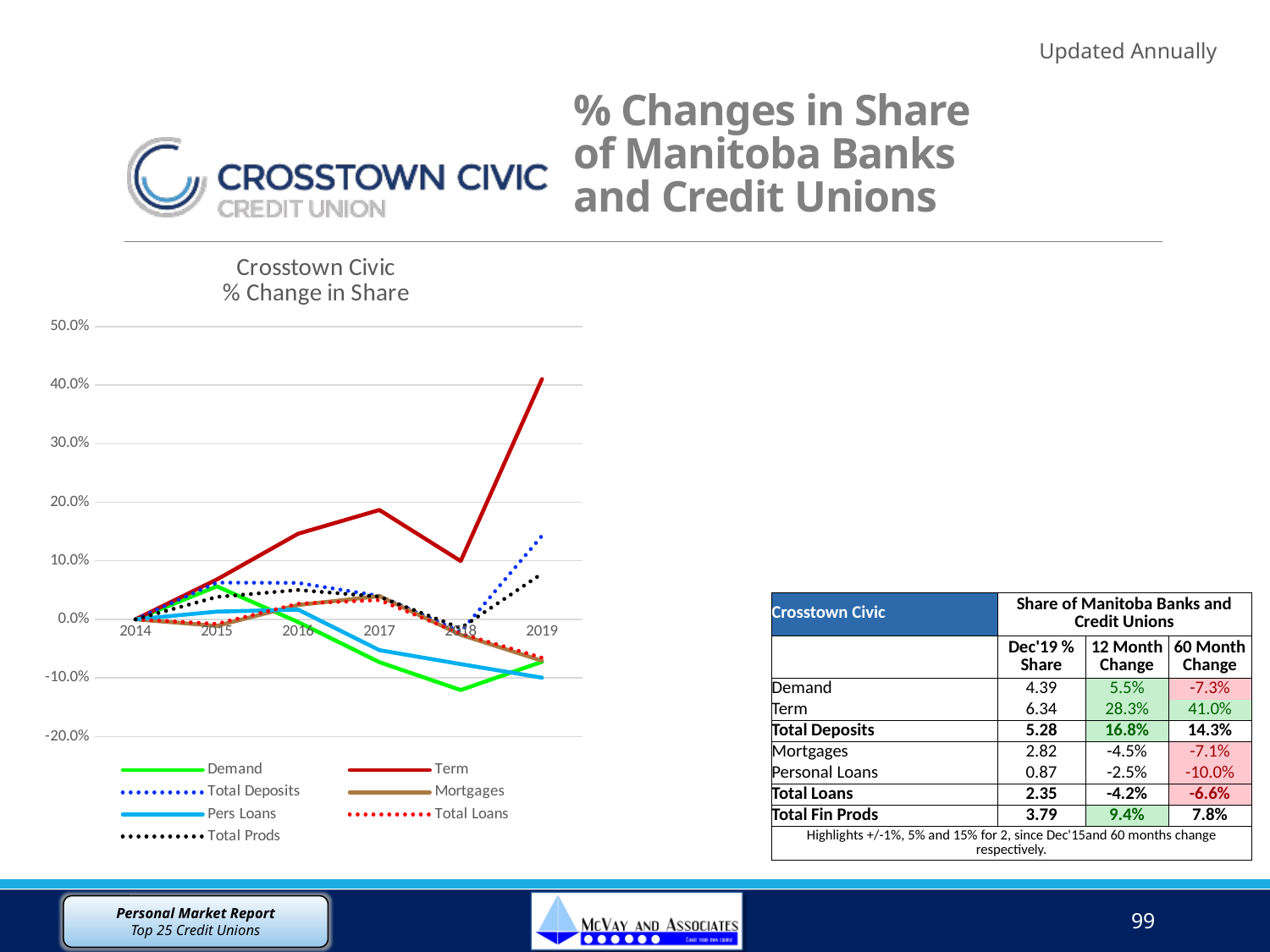
In the 'Crosstown Civic % Change in Share' chart, is the value for Term in 2019 greater or less than 30.0%? greater How many series does the legend of the 'Crosstown Civic % Change in Share' chart list? 7 In the 'Crosstown Civic % Change in Share' chart, which is larger in 2019: Term or Demand? Term In the 'Crosstown Civic % Change in Share' chart, which series has the highest value in 2019? Term In the 'Crosstown Civic % Change in Share' chart, is the value for Total Deposits in 2019 greater or less than 10.0%? greater In the 'Crosstown Civic % Change in Share' chart, is the value for Term in 2017 greater or less than 10.0%? greater In the 'Crosstown Civic % Change in Share' chart, which series has the lowest value in 2018? Demand What kind of chart is the 'Crosstown Civic % Change in Share' chart? line chart What is the first year shown on the x axis of the 'Crosstown Civic % Change in Share' chart? 2014 In the 'Crosstown Civic % Change in Share' chart, does the Term line rise or fall from 2018 to 2019? rise How many years are shown on the x axis of the 'Crosstown Civic % Change in Share' chart? 6